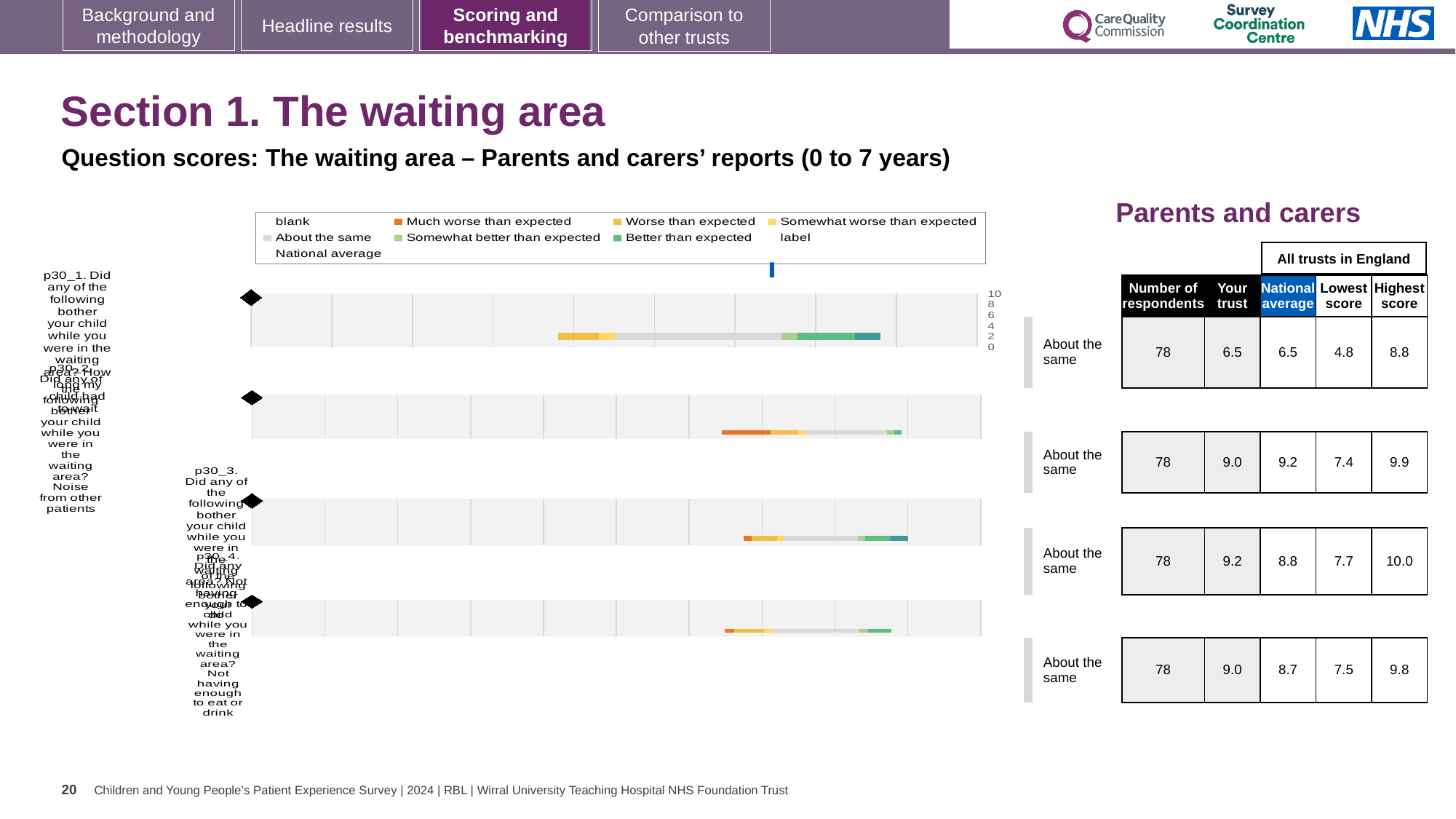
What kind of chart is shown on the slide? bar chart How many questions (bars) are plotted in the chart? 4 In the chart legend, which category is shown in teal? Better than expected How many of the four questions are rated 'About the same' compared with other trusts? 4 What is the 'Your trust' score for question p30_1 (did anything bother your child while waiting – length of wait)? 6.5 Which question has the highest 'Your trust' score? p30_3 How many respondents answered each of the waiting area questions? 78 What is the difference between the highest score (8.8) and the lowest score (4.8) for question p30_1? 4.0 Which question has the lowest 'Your trust' score? p30_1 In the chart legend, what colour represents 'Much worse than expected'? orange For question p30_2, which is larger: the 'Your trust' score or the national average? national average